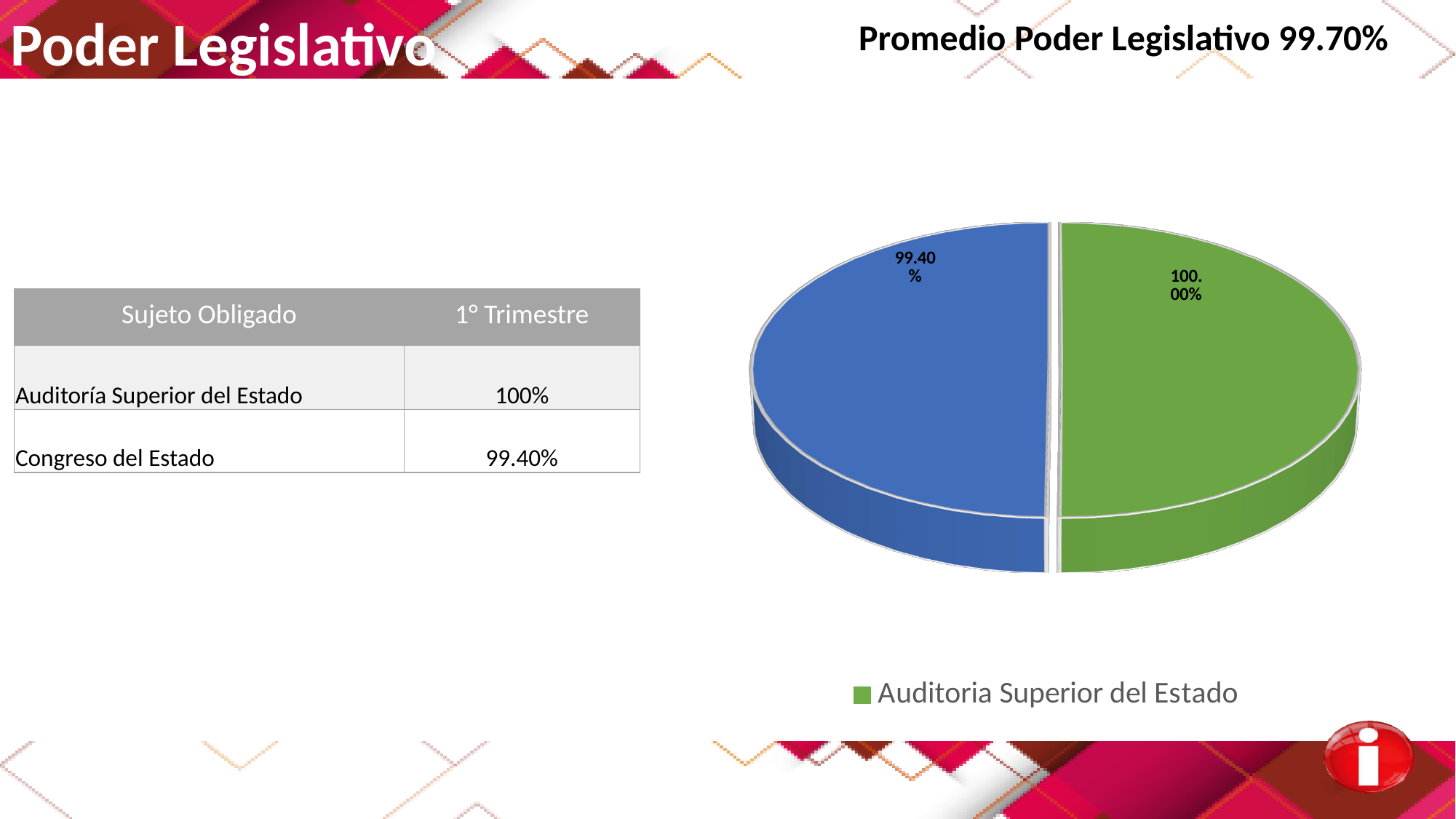
Which slice of the pie chart has the larger printed value, the green one or the blue one? the green one What colour is the slice for Auditoria Superior del Estado in the pie chart? green According to the table, what is the 1° Trimestre value for Auditoría Superior del Estado? 100% What kind of chart is shown on the slide? pie chart According to the table, what is the 1° Trimestre value for Congreso del Estado? 99.40% How many slices does the pie chart have? 2 What value is printed on the green slice of the pie chart? 100.00% Which entry does the legend of the pie chart list? Auditoria Superior del Estado How many entries does the pie chart legend list? 1 What is the difference between the values printed on the green and blue slices of the pie chart? 0.60% What value is printed on the blue slice of the pie chart? 99.40% Which slice of the pie chart has the smallest printed value? the blue slice (99.40%)